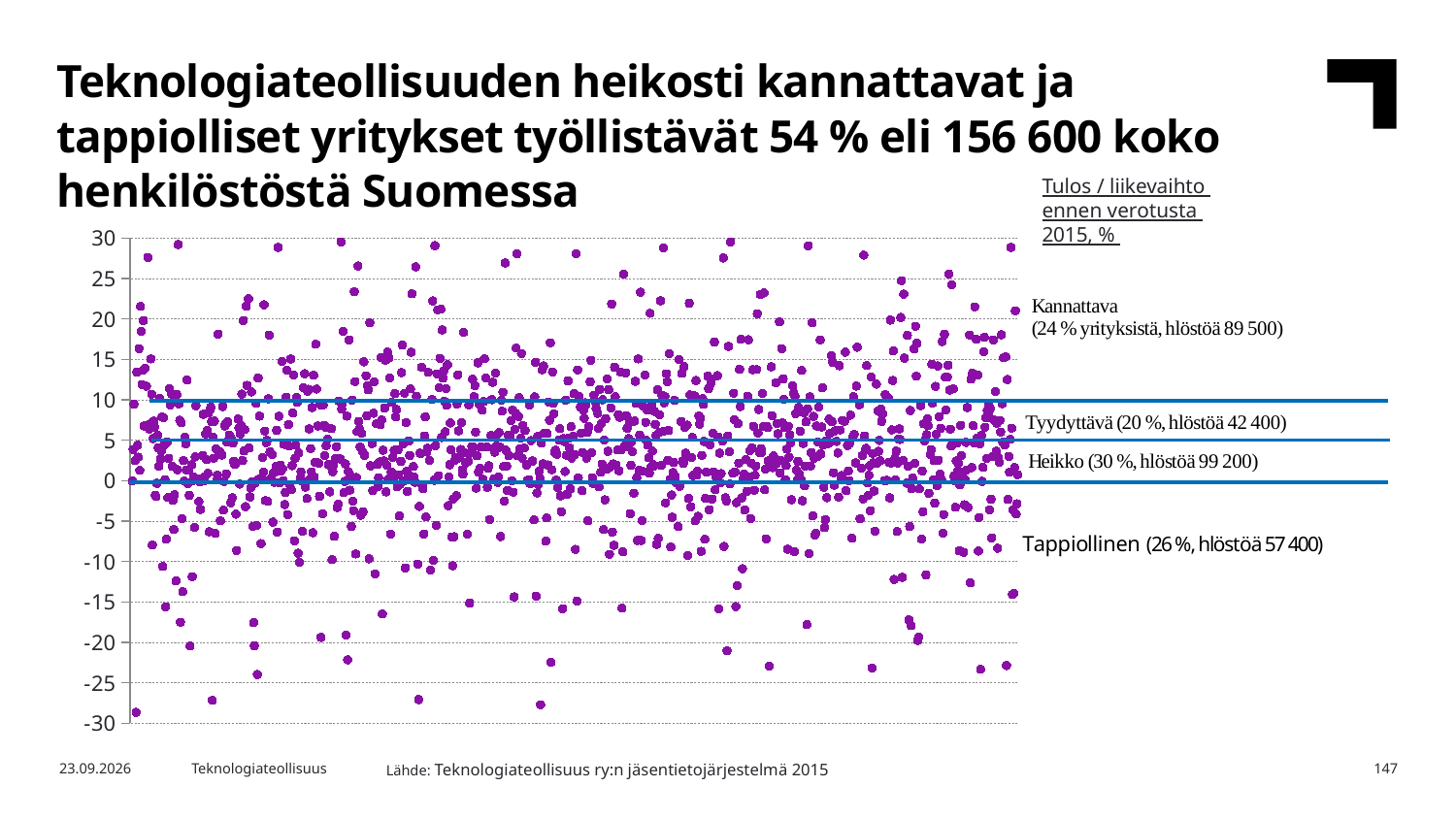
How many employees (hlöstöä) are in the Tyydyttävä category? 42 400 What is the highest value shown on the y-axis? 30 Which category has the largest number of employees? Heikko What is the difference in employees between the Heikko and Kannattava categories? 9 700 How many employees (hlöstöä) are in the Heikko category? 99 200 What kind of chart is shown on the slide? scatter chart Which category has more employees, Kannattava or Tappiollinen? Kannattava Which category has the smallest number of employees? Tyydyttävä What share of companies are in the Tappiollinen category? 26 % What share of companies are in the Kannattava category? 24 % What is the title of the chart's y-axis measure shown at the top right of the chart? Tulos / liikevaihto ennen verotusta 2015, % How many profitability categories are labelled on the chart? 4